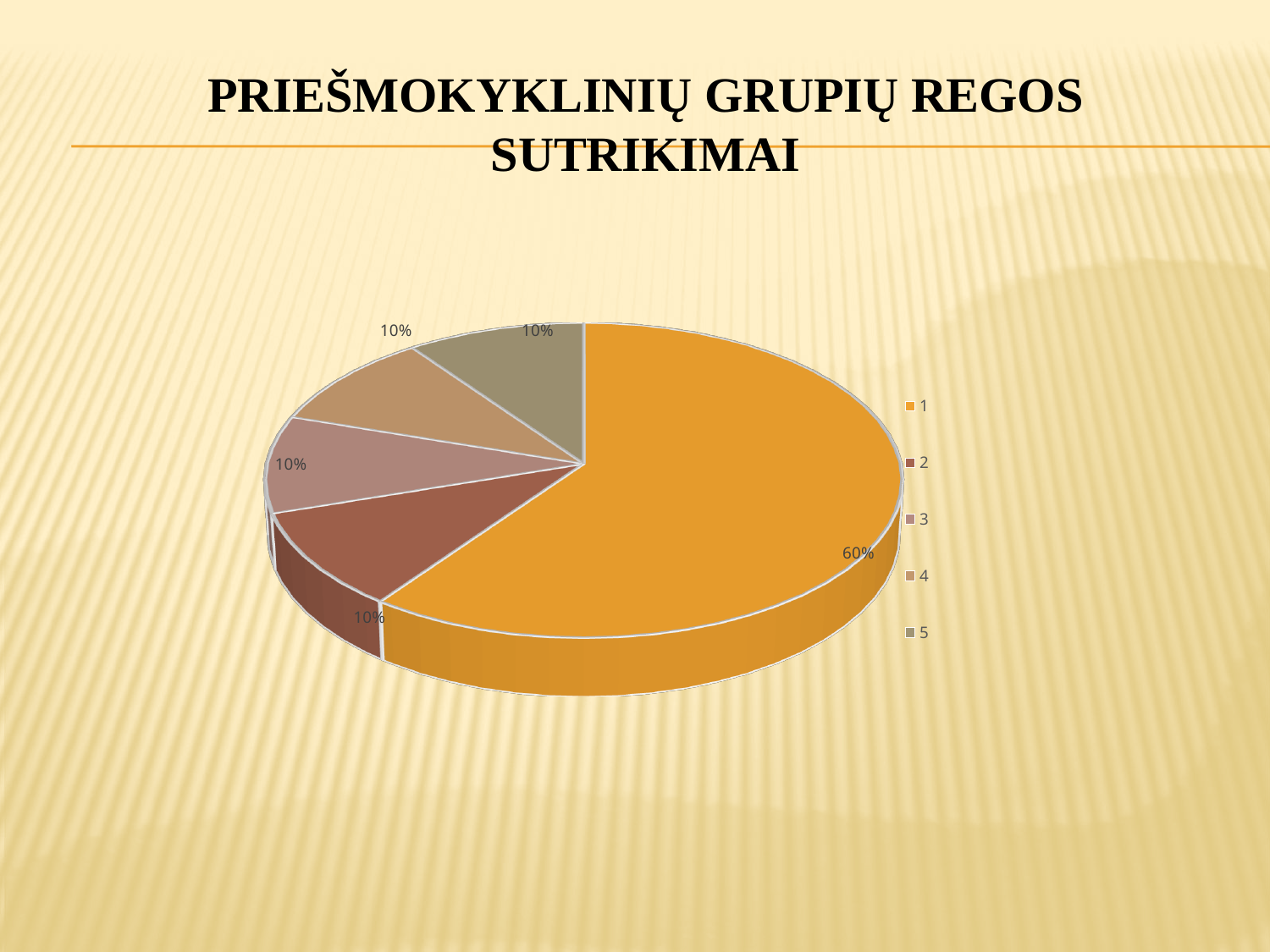
What percentage does slice 1 represent in the pie chart? 60% Is the value for slice 1 greater or less than 50%? greater What share of the pie do slices 2, 3, 4 and 5 together make up? 40% What percentage does slice 5 represent in the pie chart? 10% What is the difference in percentage points between slice 1 and slice 3? 50 What is the title of the slide containing the pie chart? PRIEŠMOKYKLINIŲ GRUPIŲ REGOS SUTRIKIMAI Which slice is the largest in the pie chart? 1 What kind of chart is shown on the slide? pie chart What percentage does slice 2 represent in the pie chart? 10% Which is larger, slice 1 or slice 4? 1 How many entries does the legend list? 5 How many slices does the pie chart have? 5